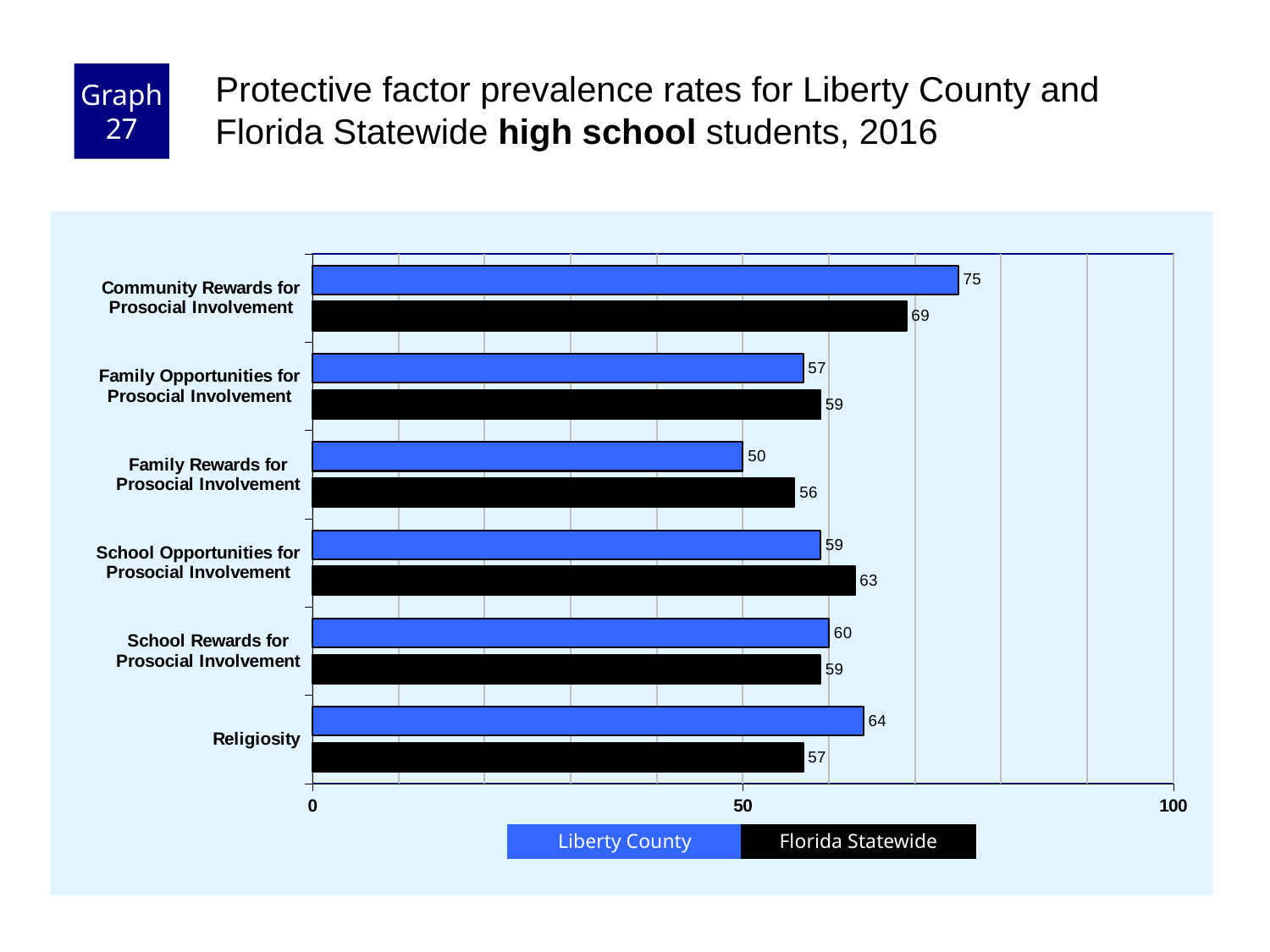
For School Opportunities for Prosocial Involvement, which is larger: Liberty County or Florida Statewide? Florida Statewide Which category has the lowest Liberty County value? Family Rewards for Prosocial Involvement Is the Florida Statewide value for Community Rewards for Prosocial Involvement greater or less than 50? greater What is the Liberty County value for Community Rewards for Prosocial Involvement? 75 What kind of chart is shown on the slide? Bar chart What is the Florida Statewide value for Family Rewards for Prosocial Involvement? 56 Which colour represents Florida Statewide in the chart? Black What is the Liberty County value for Religiosity? 64 What is the difference between the Liberty County and Florida Statewide values for Religiosity? 7 How many series does the legend list? 2 Which category has the highest Liberty County value? Community Rewards for Prosocial Involvement How many categories are shown on the chart? 6